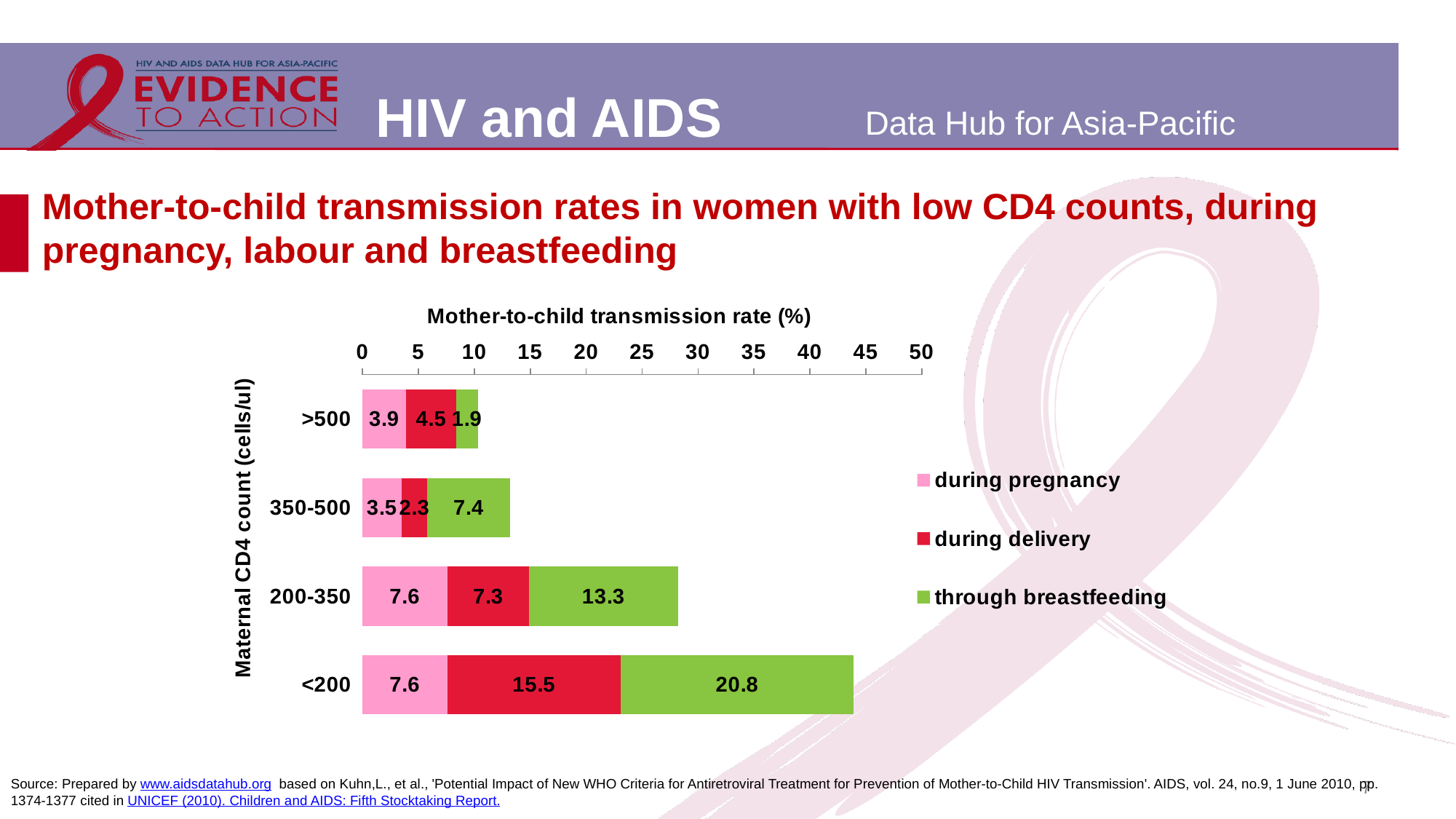
Which is larger for the 350-500 group: the rate during pregnancy or the rate during delivery? during pregnancy What is the total mother-to-child transmission rate for the <200 CD4 count group? 43.9 Which CD4 count group has the highest transmission rate through breastfeeding? <200 Which CD4 count group has the lowest transmission rate during delivery? 350-500 What is the transmission rate through breastfeeding for the <200 CD4 count group? 20.8 What is the transmission rate during pregnancy for the >500 CD4 count group? 3.9 What is the transmission rate during delivery for the 200-350 CD4 count group? 7.3 What is the difference between the during delivery rates for the <200 and 200-350 groups? 8.2 What is the title of the x axis? Mother-to-child transmission rate (%) How many maternal CD4 count categories are shown on the chart? 4 What type of chart is shown on the slide? Stacked bar chart How many series does the legend list? 3